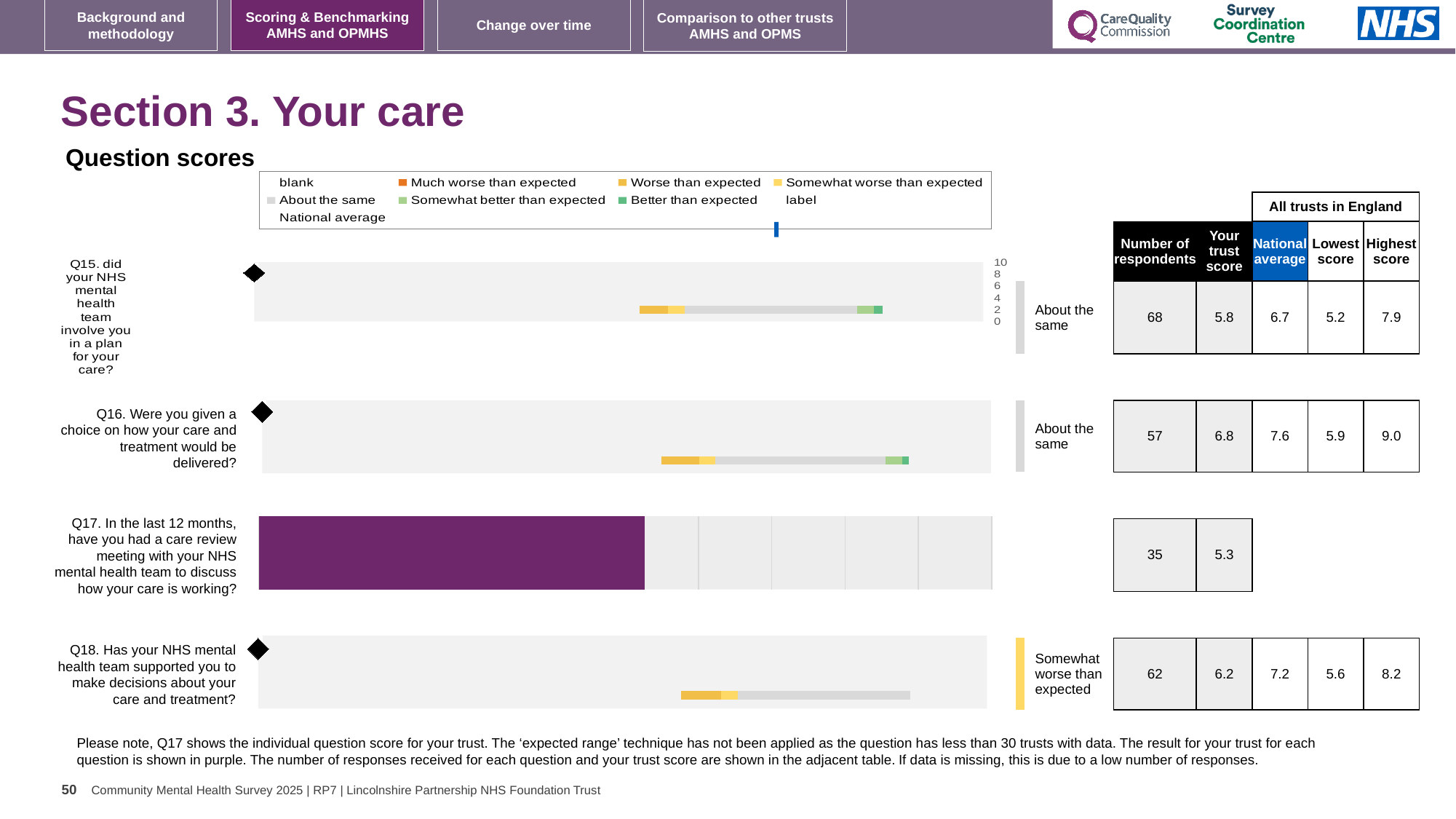
How many respondents are shown for Q15 (did your NHS mental health team involve you in a plan for your care)? 68 What is the trust score for Q16 (were you given a choice on how your care and treatment would be delivered)? 6.8 What benchmark category label is shown next to the bar for Q18? Somewhat worse than expected What is the highest score among all trusts in England for Q16? 9.0 What kind of chart is used to show the question scores? Bar chart Which question has the highest trust score? Q16 Which question has the lowest trust score? Q17 Which has the larger trust score, Q15 or Q18? Q18 What is the difference between the national average and the trust score for Q15? 0.9 What is the national average for Q18 (has your NHS mental health team supported you to make decisions about your care and treatment)? 7.2 What is the lowest score among all trusts in England for Q15? 5.2 How many questions are plotted in the chart? 4